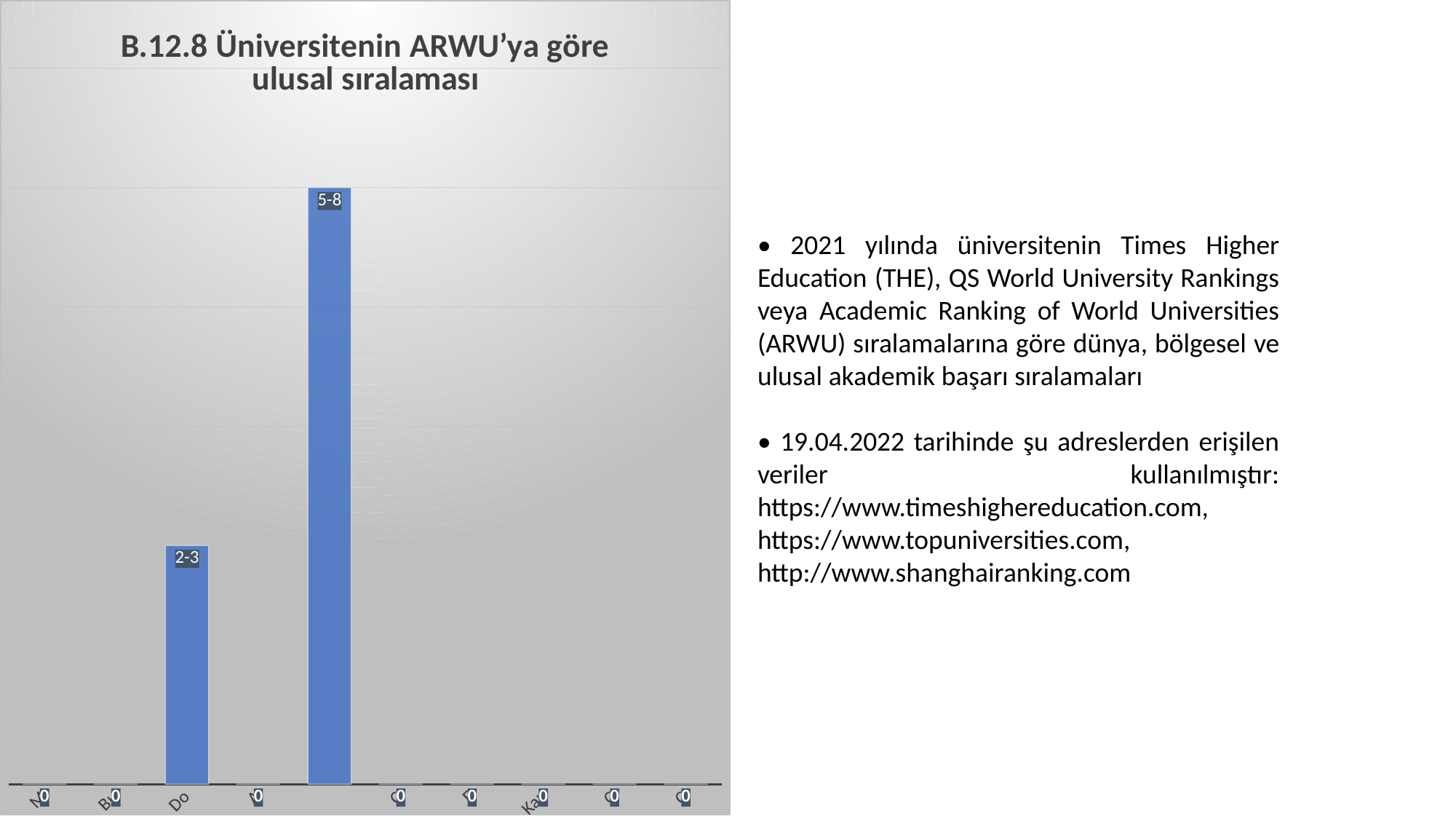
What colour are the bars in the chart? blue What is the data label on the tallest bar in the chart? 5-8 What kind of chart is shown on the slide? bar chart Which bar is taller, the one labelled 2-3 or the one labelled 5-8? 5-8 What data label is shown for the categories that have no visible bar? 0 What is the data label on the shorter of the two visible bars? 2-3 What is the title of the chart? B.12.8 Üniversitenin ARWU'ya göre ulusal sıralaması How many categories show a data label of 0? 8 How many bars in the chart have a non-zero value? 2